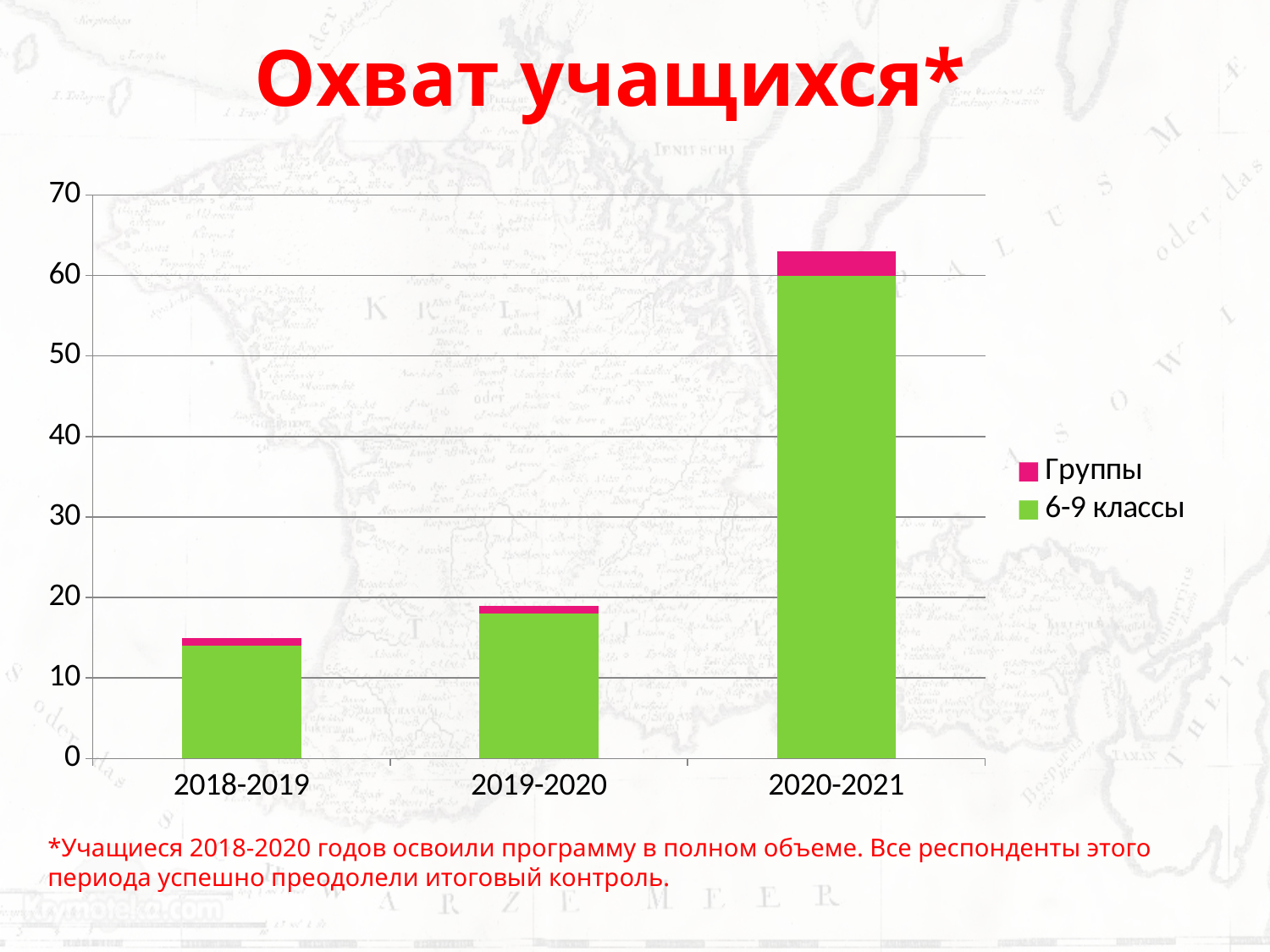
What kind of chart is shown on the slide? stacked bar chart Which school year has the tallest bar? 2020-2021 Which series is shown in green in the legend? 6-9 классы Is the total bar for 2018-2019 greater or less than 20? less How many series does the legend list? 2 Is the total bar for 2020-2021 greater or less than 60? greater Which is larger, the total bar for 2019-2020 or the total bar for 2018-2019? 2019-2020 Which school year has the shortest bar? 2018-2019 How many categories (school years) are shown on the x axis? 3 What is the title of the chart? Охват учащихся* Do the bar totals rise or fall from 2018-2019 to 2020-2021? rise